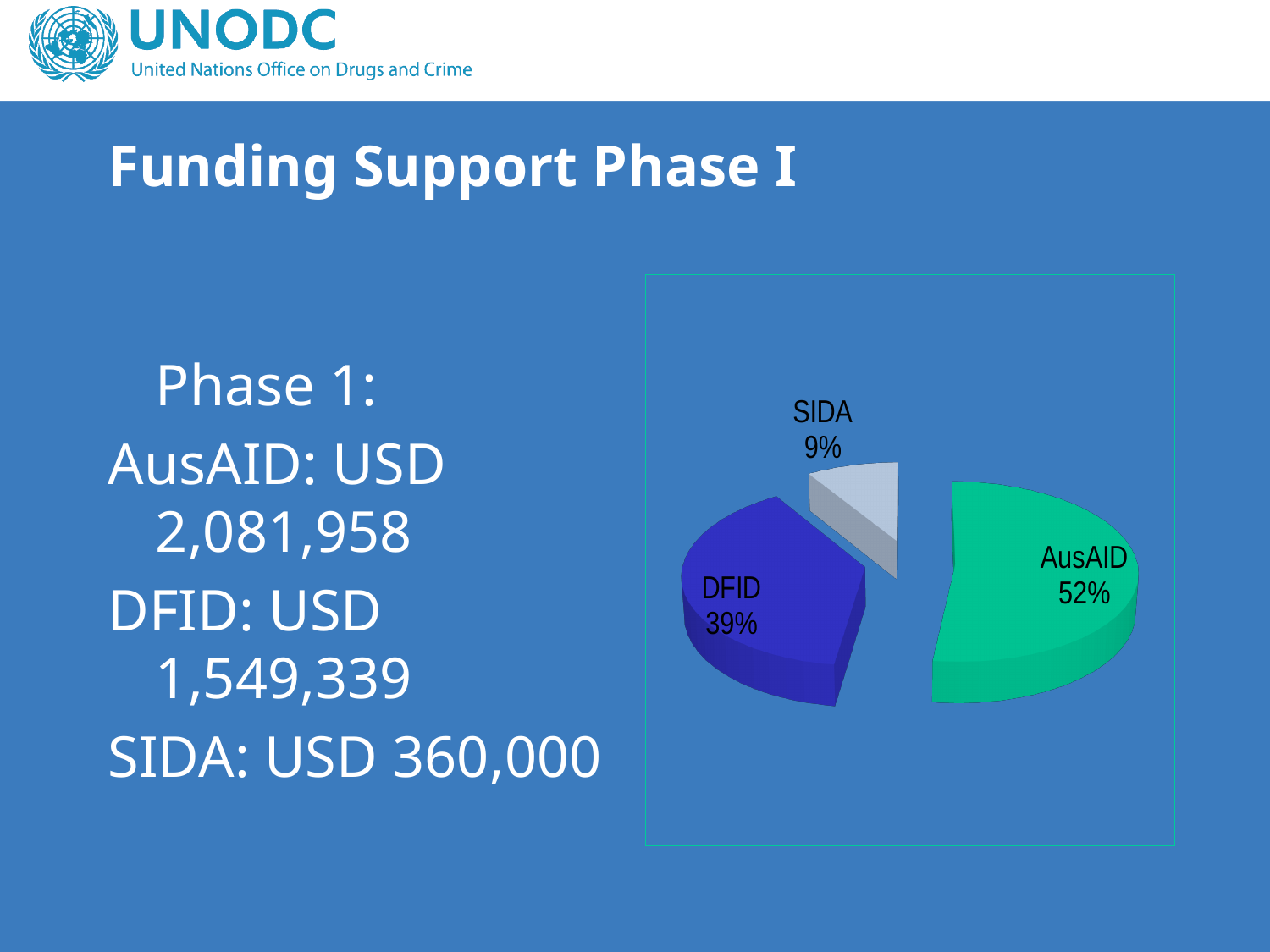
Which slice is larger, DFID or SIDA? DFID What is the difference in percentage points between the AusAID and DFID slices? 13 What share of the pie does DFID represent? 39% Which slice is larger, AusAID or DFID? AusAID How many slices does the pie chart have? 3 What is the difference in percentage points between the DFID and SIDA slices? 30 What colour is the AusAID slice of the pie? green Which funder has the smallest slice of the pie? SIDA What share of the pie does AusAID represent? 52% What kind of chart is shown on the slide? pie chart What share of the pie does SIDA represent? 9% Which funder has the largest slice of the pie? AusAID